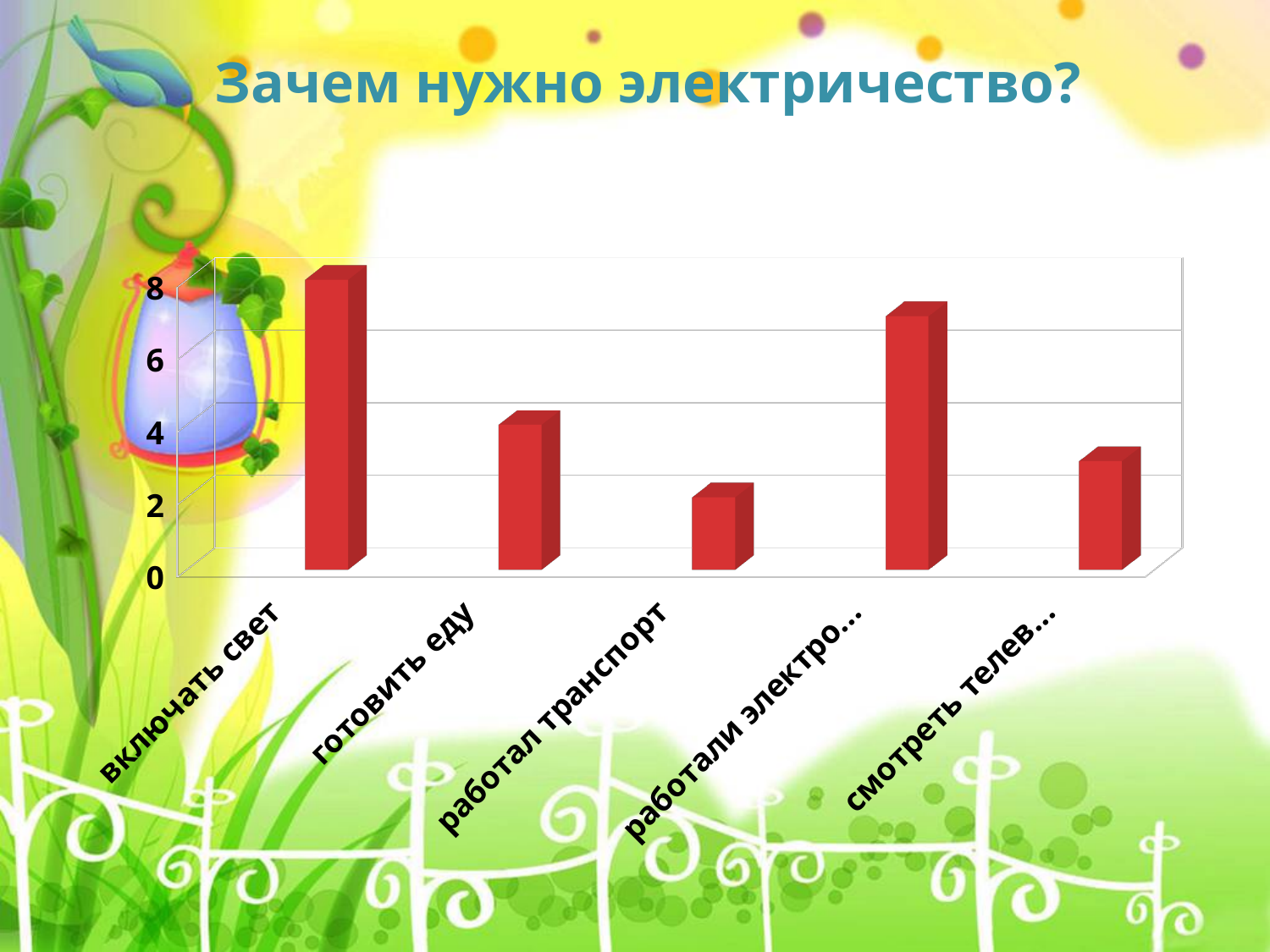
Is the value for "работал транспорт" greater or less than 4? less Which category has the lowest bar? работал транспорт Which is larger, the value for "работали электро…" or the value for "смотреть телев…"? работали электро… Is the value for "включать свет" greater or less than 6? greater Which category has the highest bar? включать свет How many categories are plotted in the chart? 5 Is the value for "работали электро…" greater or less than 6? greater What is the title of the slide above the chart? Зачем нужно электричество? Which is larger, the value for "готовить еду" or the value for "работал транспорт"? готовить еду What kind of chart is shown on the slide? bar chart Which is larger, the value for "включать свет" or the value for "готовить еду"? включать свет